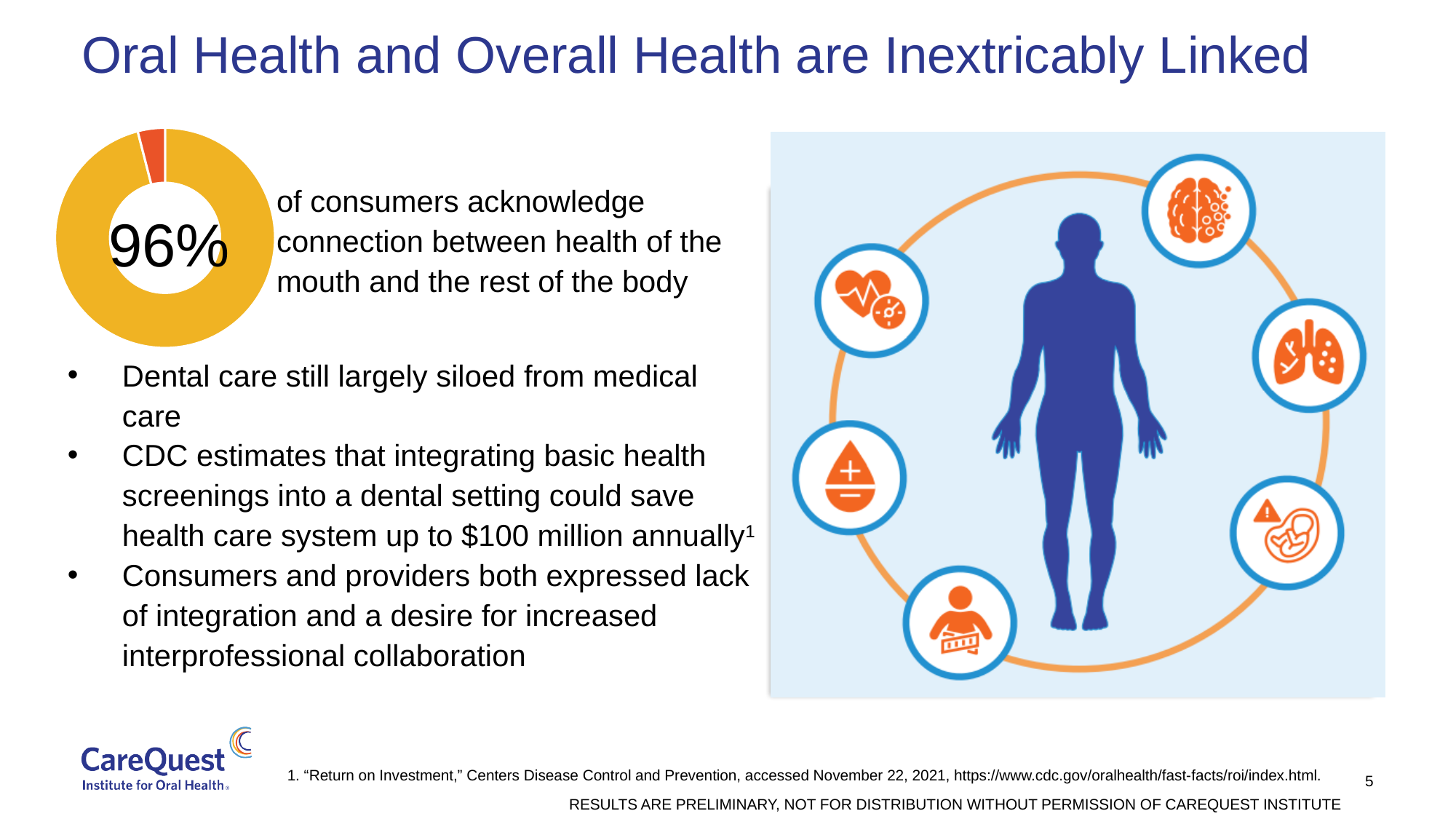
Is the value shown in the donut chart greater or less than 50%? greater What colour is the small slice of the donut chart? Orange Which slice of the donut chart is larger, the yellow one or the orange one? The yellow one What share of consumers acknowledge a connection between health of the mouth and the rest of the body, according to the donut chart? 96% How many slices does the donut chart have? 2 What kind of chart is shown on the left of the slide? Donut (pie) chart What percentage is printed in the centre of the donut chart? 96% What colour is the large slice of the donut chart? Yellow